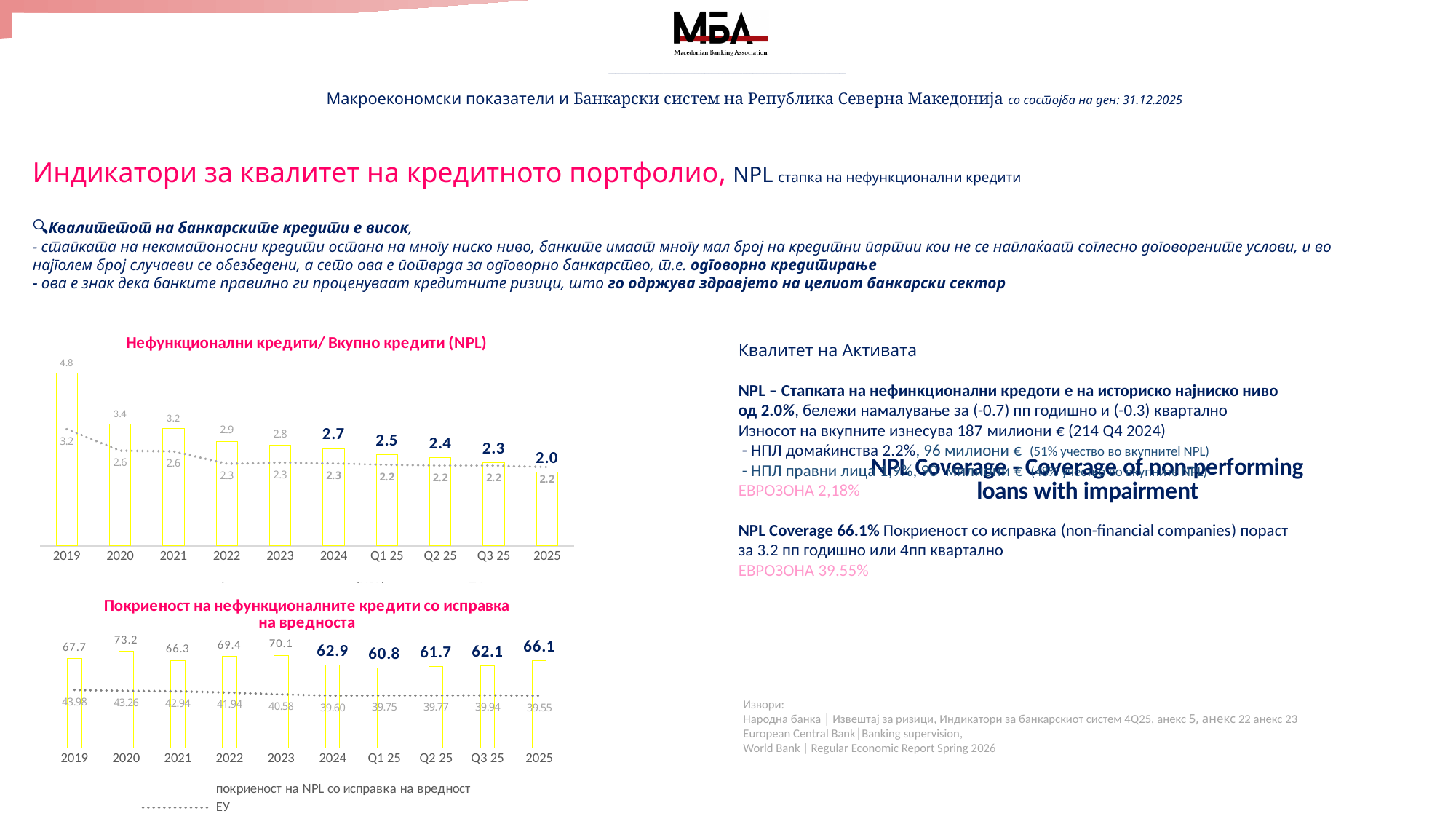
In the chart titled "Нефункционални кредити/ Вкупно кредити (NPL)", what is the difference between the bar values for 2019 and 2020? 1.4 In the chart titled "Нефункционални кредити/ Вкупно кредити (NPL)", do the bar values rise or fall from 2019 to 2025? fall In the chart titled "Покриеност на нефункционалните кредити со исправка на вредноста", which is larger: the bar value for 2023 or for 2024? 2023 In the chart titled "Нефункционални кредити/ Вкупно кредити (NPL)", how many categories are shown on the x axis? 10 In the chart titled "Нефункционални кредити/ Вкупно кредити (NPL)", what is the NPL value for 2019? 4.8 In the chart titled "Покриеност на нефункционалните кредити со исправка на вредноста", how many series does the legend list? 2 In the chart titled "Покриеност на нефункционалните кредити со исправка на вредноста", which category has the lowest bar value? Q1 25 In the chart titled "Покриеност на нефункционалните кредити со исправка на вредноста", what is the ЕУ value for 2025? 39.55 In the chart titled "Нефункционални кредити/ Вкупно кредити (NPL)", what is the bar value for 2025? 2.0 In the chart titled "Покриеност на нефункционалните кредити со исправка на вредноста", what is the bar value for 2020? 73.2 In the chart titled "Нефункционални кредити/ Вкупно кредити (NPL)", which category has the highest bar value? 2019 What kind of chart is the chart titled "Покриеност на нефункционалните кредити со исправка на вредноста"? bar chart with a dotted line